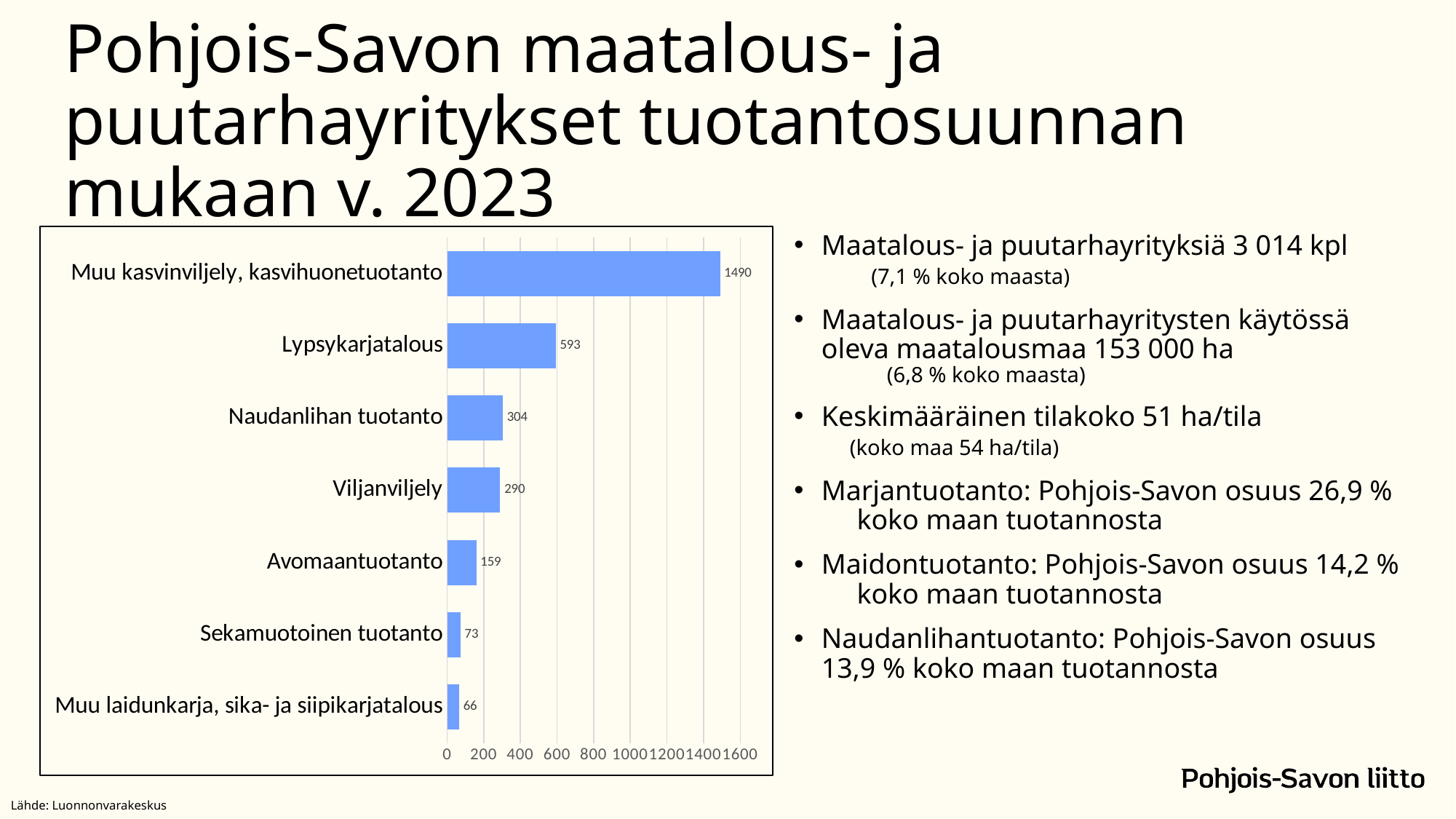
What is the value for Lypsykarjatalous? 593 Is the value for Lypsykarjatalous greater or less than 400? greater Which category has the lowest value? Muu laidunkarja, sika- ja siipikarjatalous Which is larger, the value for Naudanlihan tuotanto or the value for Viljanviljely? Naudanlihan tuotanto What is the value for Naudanlihan tuotanto? 304 What is the value for Avomaantuotanto? 159 What is the difference between the values for Muu kasvinviljely, kasvihuonetuotanto and Lypsykarjatalous? 897 What is the difference between the values for Sekamuotoinen tuotanto and Muu laidunkarja, sika- ja siipikarjatalous? 7 Which category has the highest value? Muu kasvinviljely, kasvihuonetuotanto What kind of chart is shown on the slide? bar chart What is the value for Muu laidunkarja, sika- ja siipikarjatalous? 66 How many categories are shown in the chart? 7